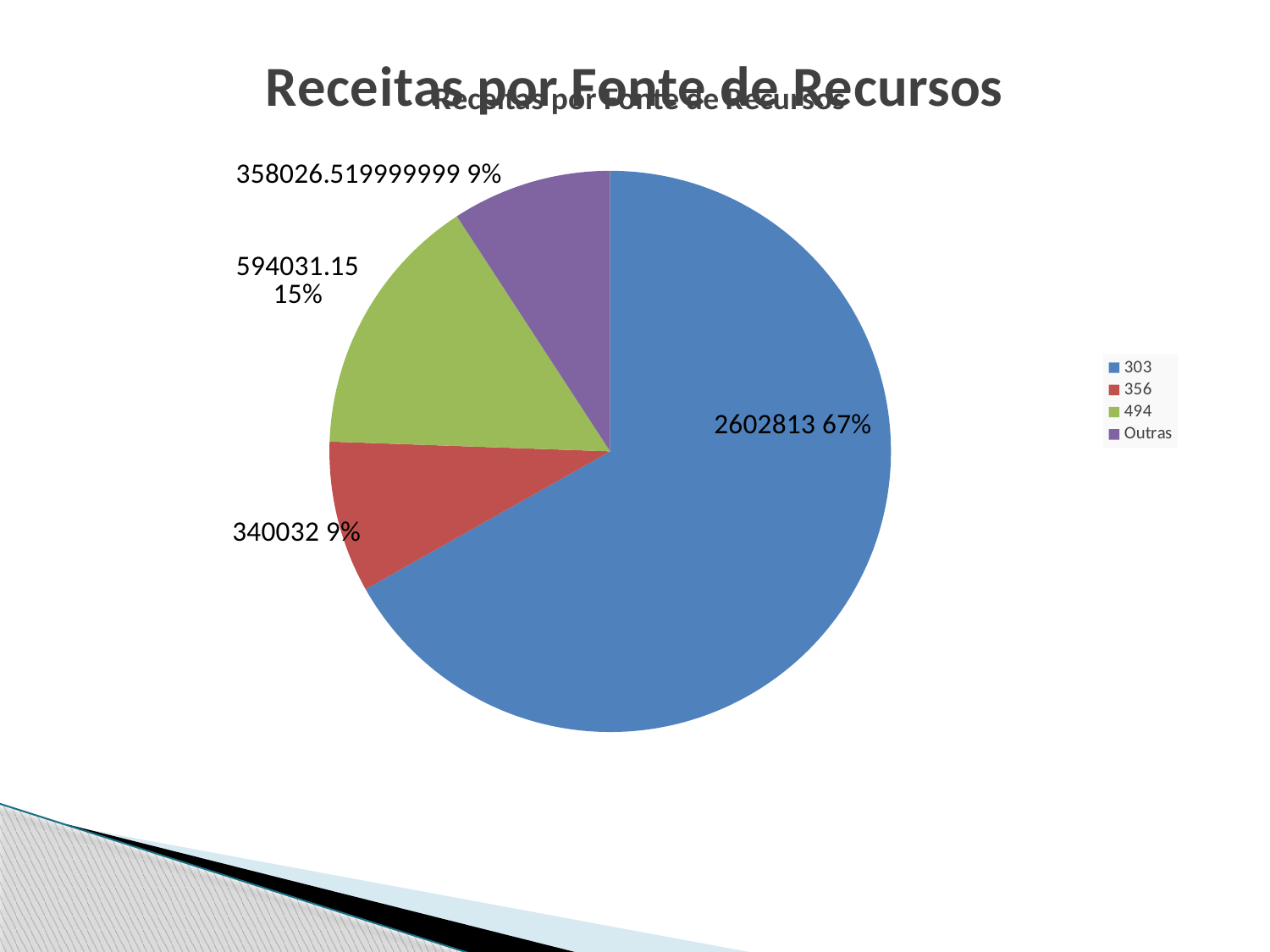
What is the value for category 356? 340032 What is the value for category 303? 2602813 What share of the pie does category 494 represent? 15% What is the value for category 494? 594031.15 How many slices does the pie chart have? 4 What colour is the slice for category 494? green What is the value for the Outras slice? 358026.519999999 Which is larger, the value for 494 or the value for 356? 494 What kind of chart is shown on the slide? pie chart What share of the pie does category 303 represent? 67% Which category has the largest slice of the pie? 303 What is the difference between the value for 303 and the value for 494? 2008781.85